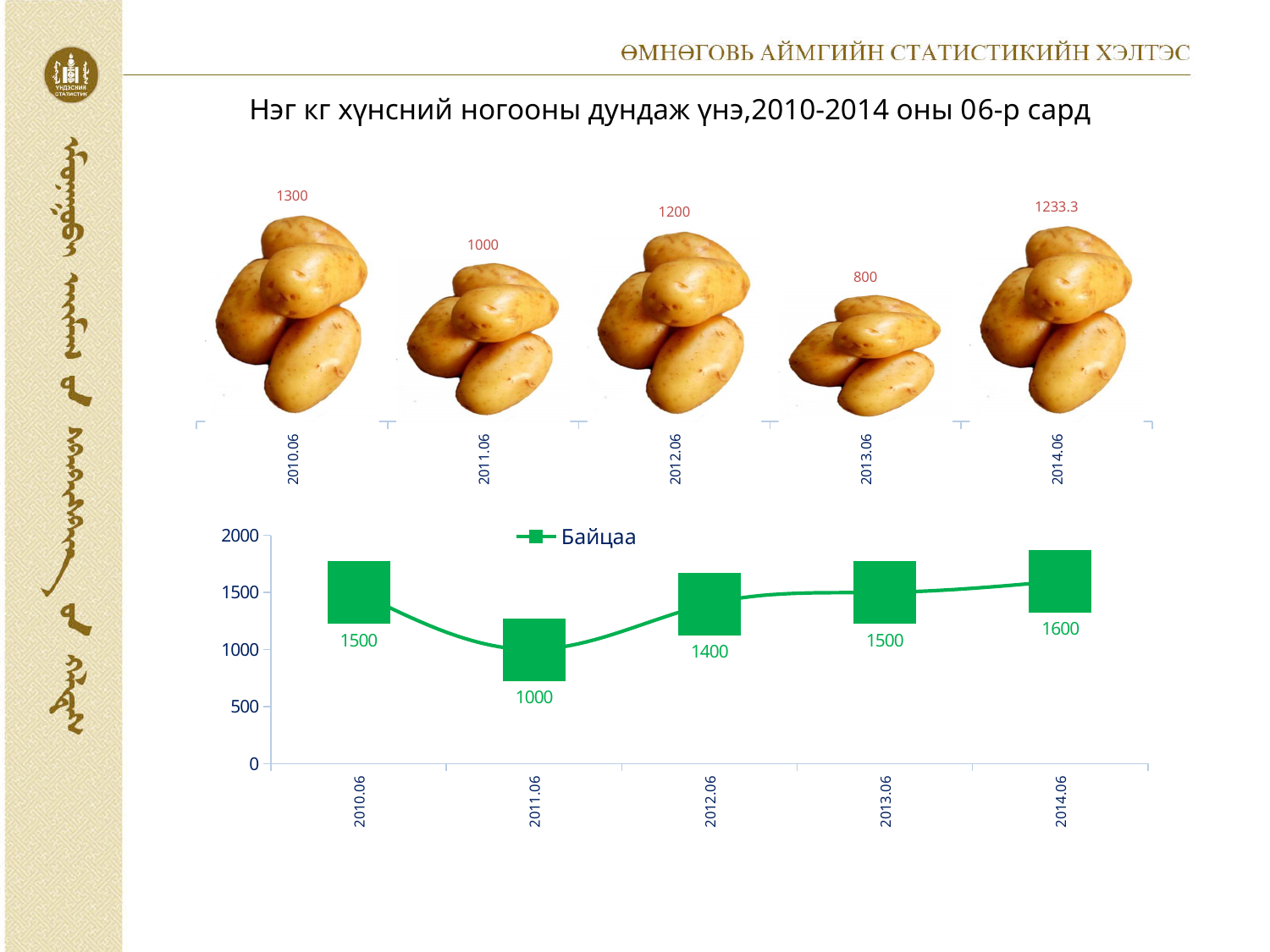
In the bottom chart (Байцаа), which period has the highest value? 2014.06 In the bottom chart (Байцаа), what is the value for 2014.06? 1600 In the bottom chart (Байцаа), what is the difference between the values for 2010.06 and 2011.06? 500 In the top chart (potato images), what is the value for 2010.06? 1300 In the bottom chart (Байцаа), is the value for 2012.06 larger or smaller than the value for 2013.06? smaller In the bottom chart (Байцаа), what is the value for 2011.06? 1000 In the bottom chart, what series name does the legend show? Байцаа In the top chart (potato images), which period has the highest value? 2010.06 In the top chart (potato images), what is the value for 2014.06? 1233.3 In the top chart (potato images), how many periods are shown on the x axis? 5 In the top chart (potato images), what is the difference between the values for 2012.06 and 2013.06? 400 In the top chart (potato images), which period has the lowest value? 2013.06